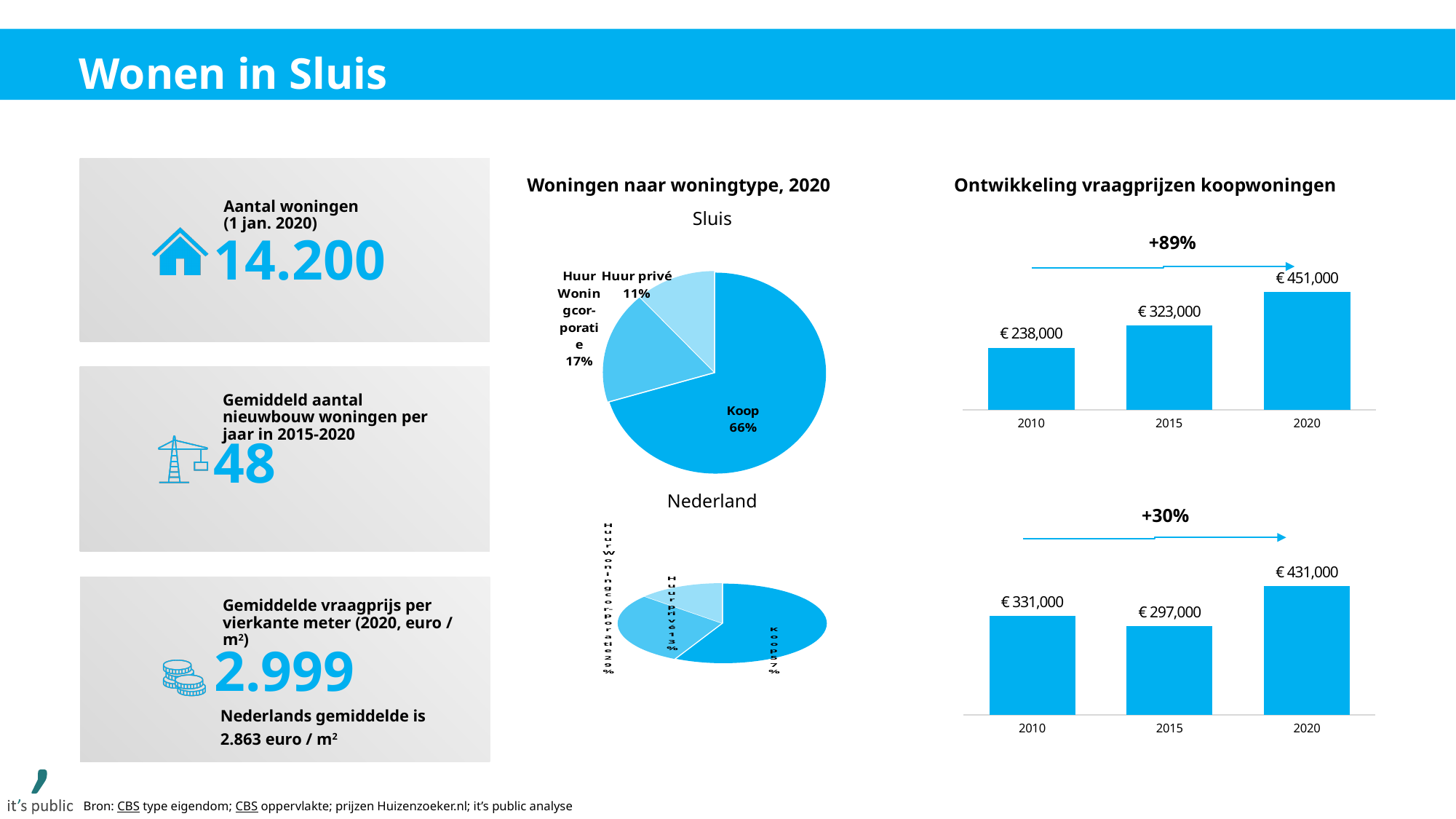
What percentage increase is shown above the upper bar chart under 'Ontwikkeling vraagprijzen koopwoningen'? +89% In the lower bar chart under 'Ontwikkeling vraagprijzen koopwoningen', which is larger: the 2010 value or the 2015 value? 2010 In the lower bar chart under 'Ontwikkeling vraagprijzen koopwoningen', which year has the lowest value? 2015 In the upper bar chart under 'Ontwikkeling vraagprijzen koopwoningen', what is the difference between the 2020 and 2010 values? € 213,000 In the Sluis pie chart, which category has the largest share? Koop In the upper bar chart under 'Ontwikkeling vraagprijzen koopwoningen', do the values rise or fall from 2010 to 2020? rise In the Sluis pie chart, how many slices are there? 3 In the Sluis pie chart, what share is Huur privé? 11% In the upper bar chart under 'Ontwikkeling vraagprijzen koopwoningen', what is the value for 2015? € 323,000 In the Sluis pie chart under 'Woningen naar woningtype, 2020', what share is Koop? 66% In the Sluis pie chart, which category has the smallest share? Huur privé In the lower bar chart under 'Ontwikkeling vraagprijzen koopwoningen', what is the value for 2010? € 331,000